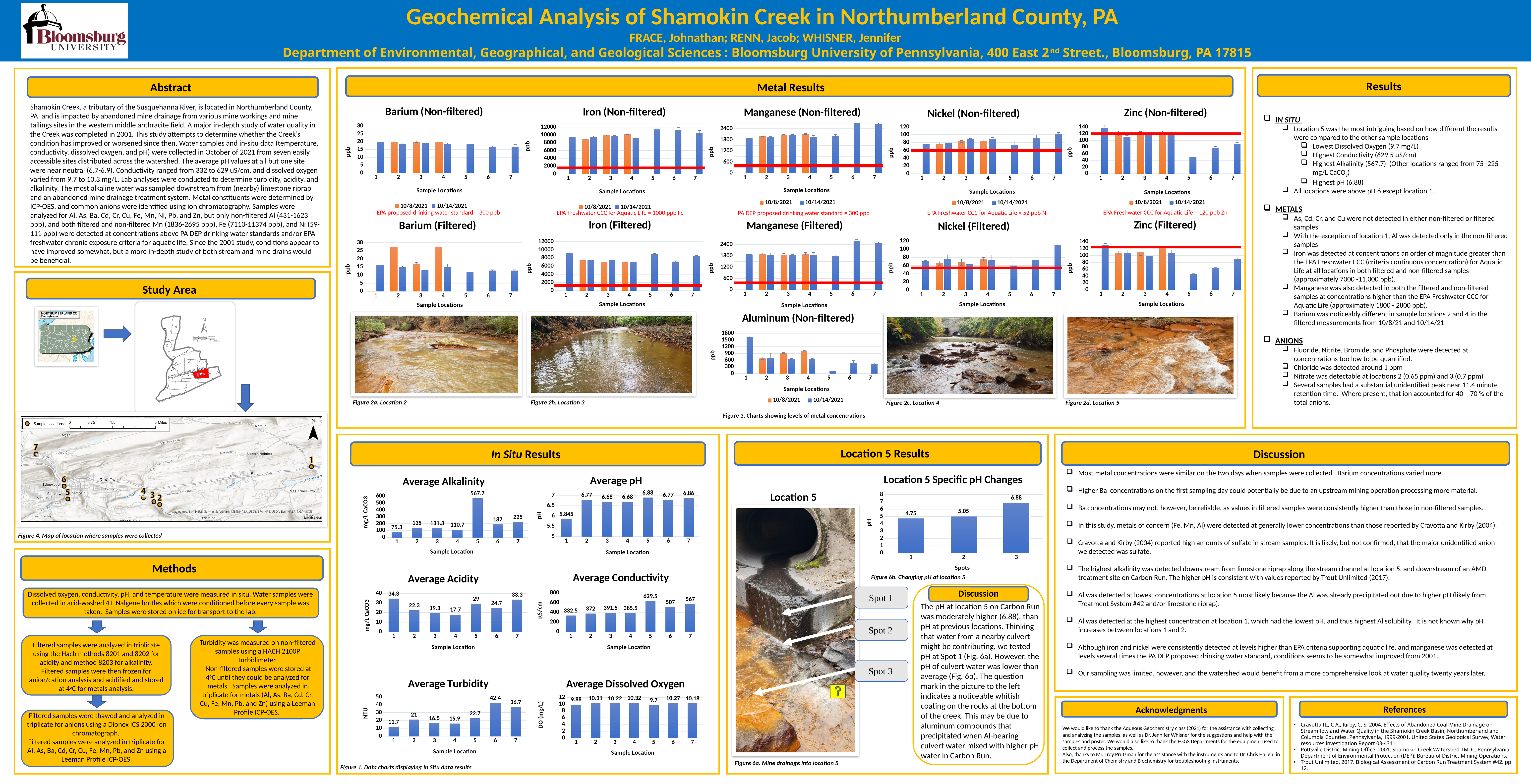
In the Location 5 Specific pH Changes chart, how many spots are plotted? 3 In the Average Turbidity chart, which sample location has the highest value? 6 In the Location 5 Specific pH Changes chart, what is the pH at spot 3? 6.88 In the Average pH chart, which is larger: the value for sample location 1 or sample location 5? sample location 5 In the Average Alkalinity chart, what is the value for sample location 5? 567.7 In the Average Dissolved Oxygen chart, what is the value for sample location 5? 9.7 In the Average Alkalinity chart, which sample location has the lowest value? 1 What kind of chart is the Average Alkalinity chart? bar chart In the Average Acidity chart, what is the value for sample location 4? 17.7 In the Average Conductivity chart, what is the value for sample location 1? 332.5 How many series does the legend of the Iron (Non-filtered) chart list? 2 In the Average Conductivity chart, what is the difference between sample location 5 and sample location 1? 297